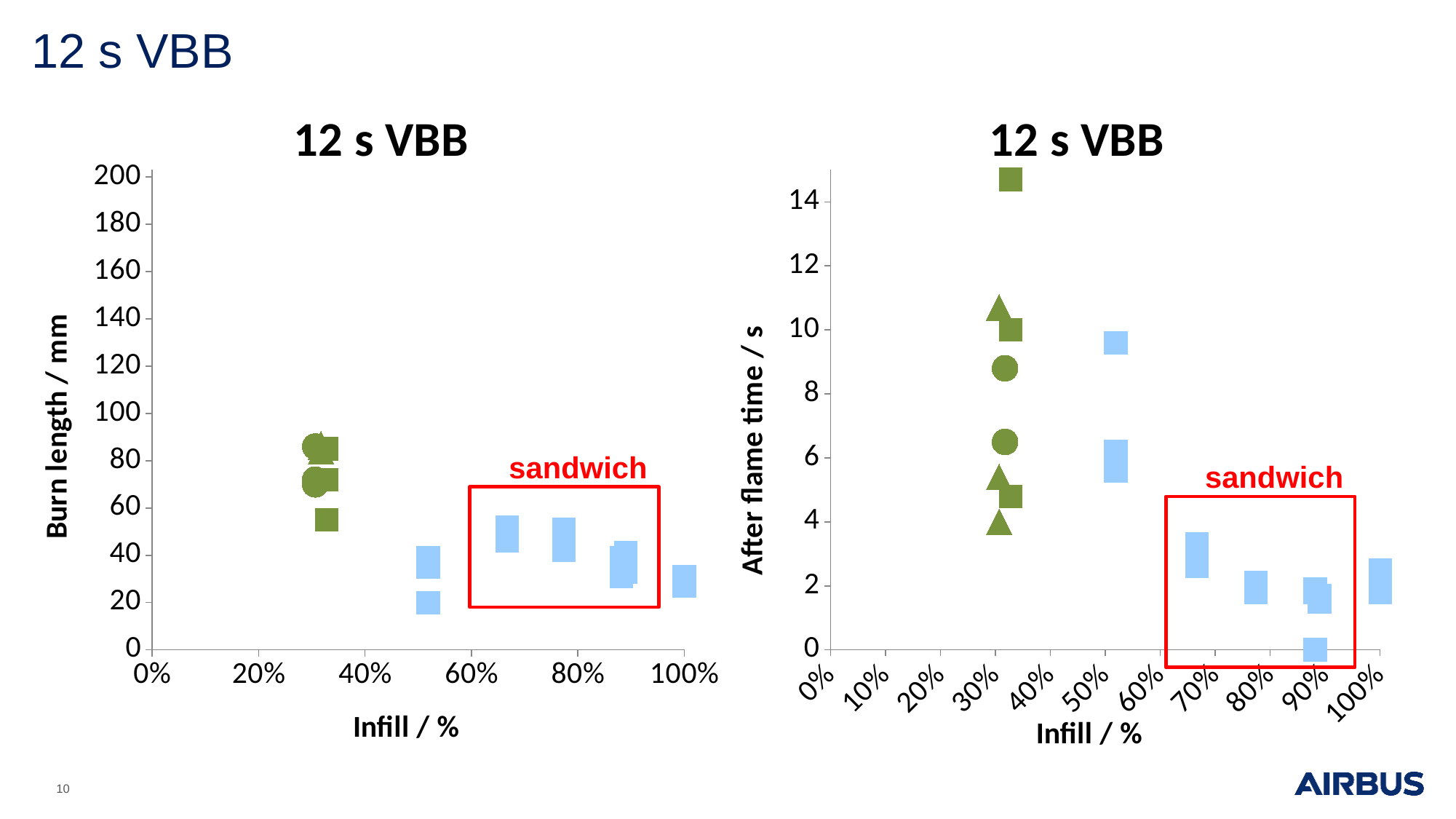
In the right chart, is the highest green marker greater or less than 14 s? greater In the right chart, is the highest blue marker greater or less than 8 s? greater In the left chart, is the highest green marker greater or less than 100 mm? less How many charts are shown on the slide? 2 In the right chart, which group of markers has the higher after flame time values, the green markers or the blue markers? green markers What is the y-axis title of the left chart? Burn length / mm What is the y-axis title of the right chart? After flame time / s In the right chart, do the blue markers generally rise or fall as infill increases from 50% to 90%? fall What kind of chart is the left chart on the slide? scatter chart